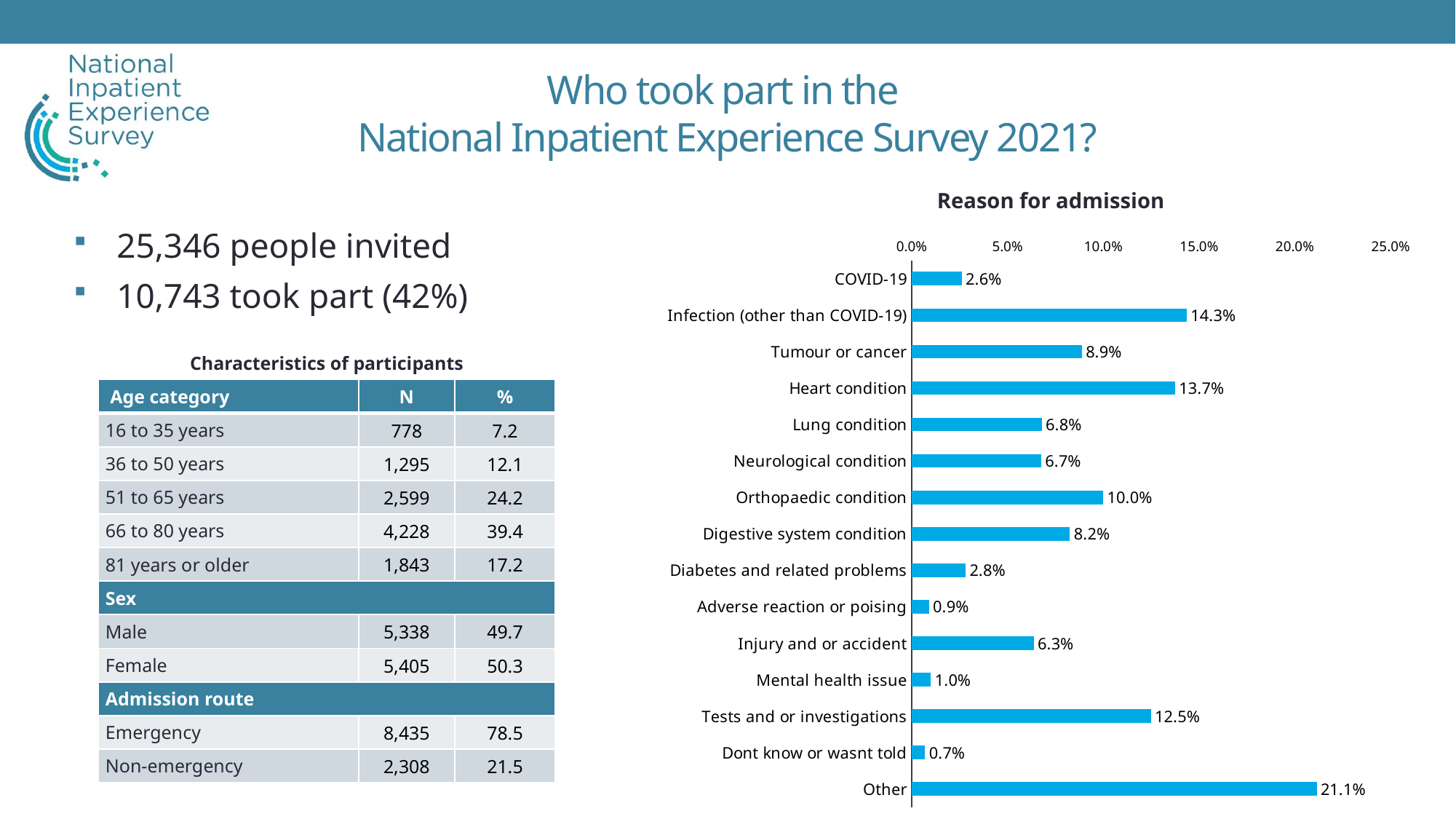
What is the difference between the values for Infection (other than COVID-19) and Heart condition in the Reason for admission chart? 0.6% What is the value for Mental health issue in the Reason for admission chart? 1.0% Which reason for admission has the highest value in the chart? Other Which reason for admission has the lowest value in the chart? Dont know or wasnt told In the Reason for admission chart, which is larger: Tumour or cancer or Digestive system condition? Tumour or cancer What is the difference between the values for Other and Orthopaedic condition in the Reason for admission chart? 11.1% What is the value for Infection (other than COVID-19) in the Reason for admission chart? 14.3% Is the value for Orthopaedic condition greater or less than 5.0% in the Reason for admission chart? greater What kind of chart is used to show the reason for admission? Bar chart What is the title of the chart on the slide? Reason for admission How many reasons for admission are shown in the chart? 15 What is the value for Tests and or investigations in the Reason for admission chart? 12.5%